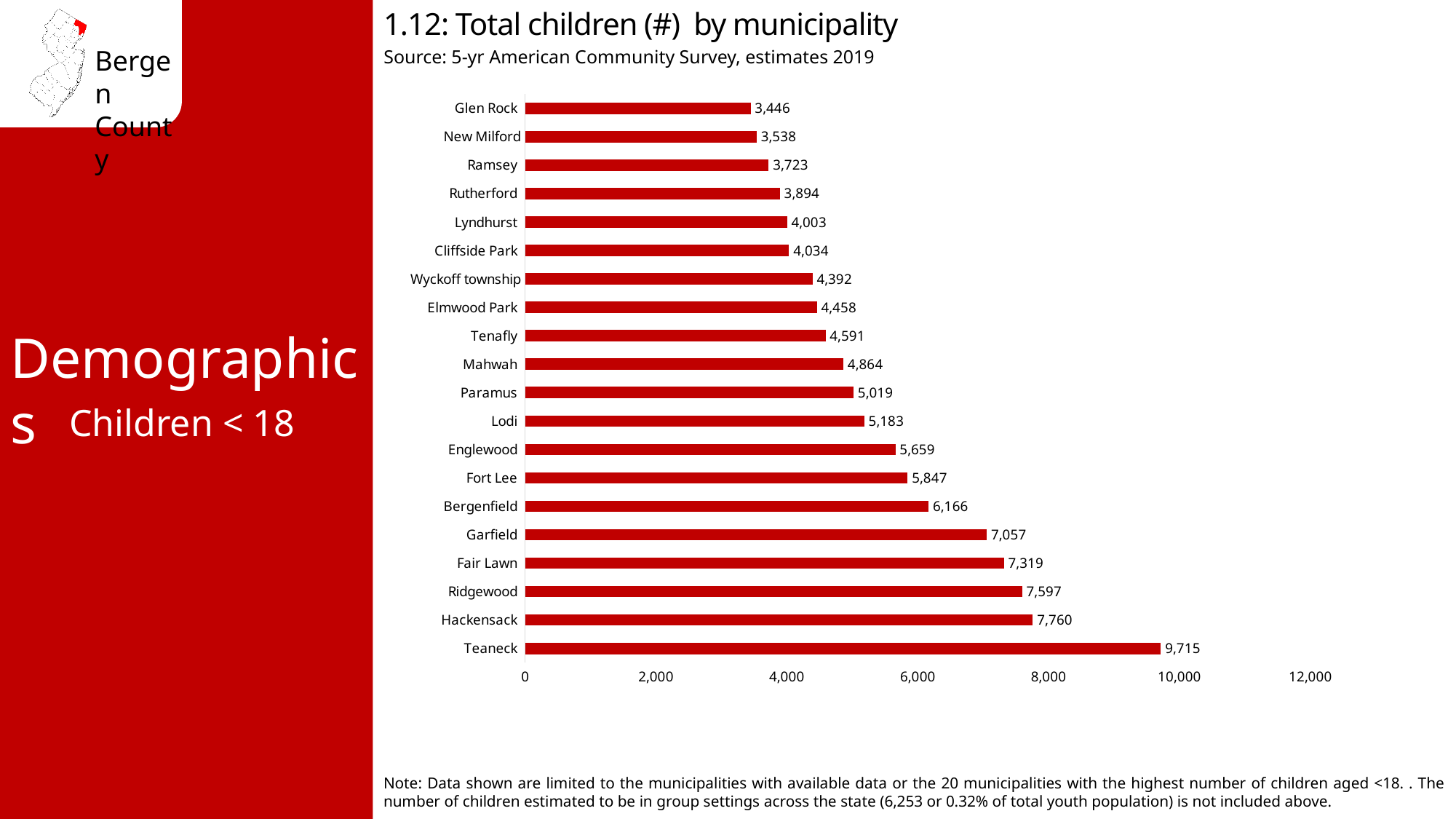
What is the difference between the number of children in Teaneck and Hackensack? 1,955 What is the total number of children for Teaneck? 9,715 Which municipality has the lowest number of children? Glen Rock Which has more children, Englewood or Fort Lee? Fort Lee Which municipality has the highest number of children? Teaneck What is the title of the chart? 1.12: Total children (#) by municipality What is the total number of children for Paramus? 5,019 What is the difference between the number of children in Fair Lawn and Garfield? 262 Is the value for Bergenfield greater or less than 6,000? greater What is the total number of children for Wyckoff township? 4,392 How many municipalities are shown in the chart? 20 What kind of chart is shown on the slide? bar chart